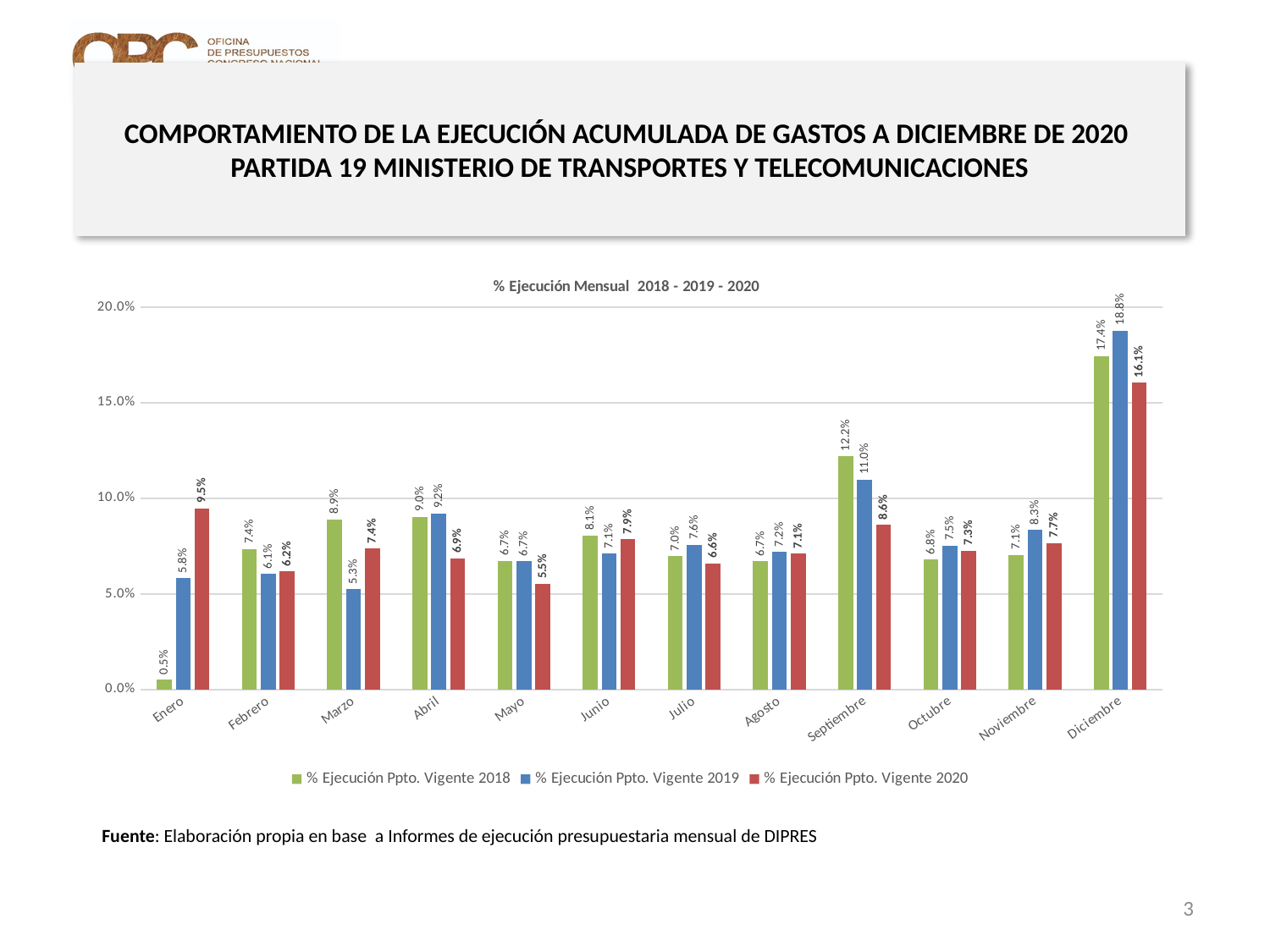
What is the % Ejecución Ppto. Vigente 2019 value for Diciembre? 18.8% What is the title of the chart? % Ejecución Mensual 2018 - 2019 - 2020 What kind of chart is shown on the slide? Bar chart What is the % Ejecución Ppto. Vigente 2018 value for Septiembre? 12.2% In which month is the % Ejecución Ppto. Vigente 2020 value the highest? Diciembre What is the % Ejecución Ppto. Vigente 2020 value for Enero? 9.5% How many months are shown on the x axis? 12 How many series does the legend list? 3 In which month is the % Ejecución Ppto. Vigente 2018 value the lowest? Enero What is the difference between the 2019 and 2018 values for Diciembre? 1.4% Which is larger for Marzo: the 2018 value or the 2019 value? 2018 Is the % Ejecución Ppto. Vigente 2019 value for Septiembre greater or less than 10.0%? greater